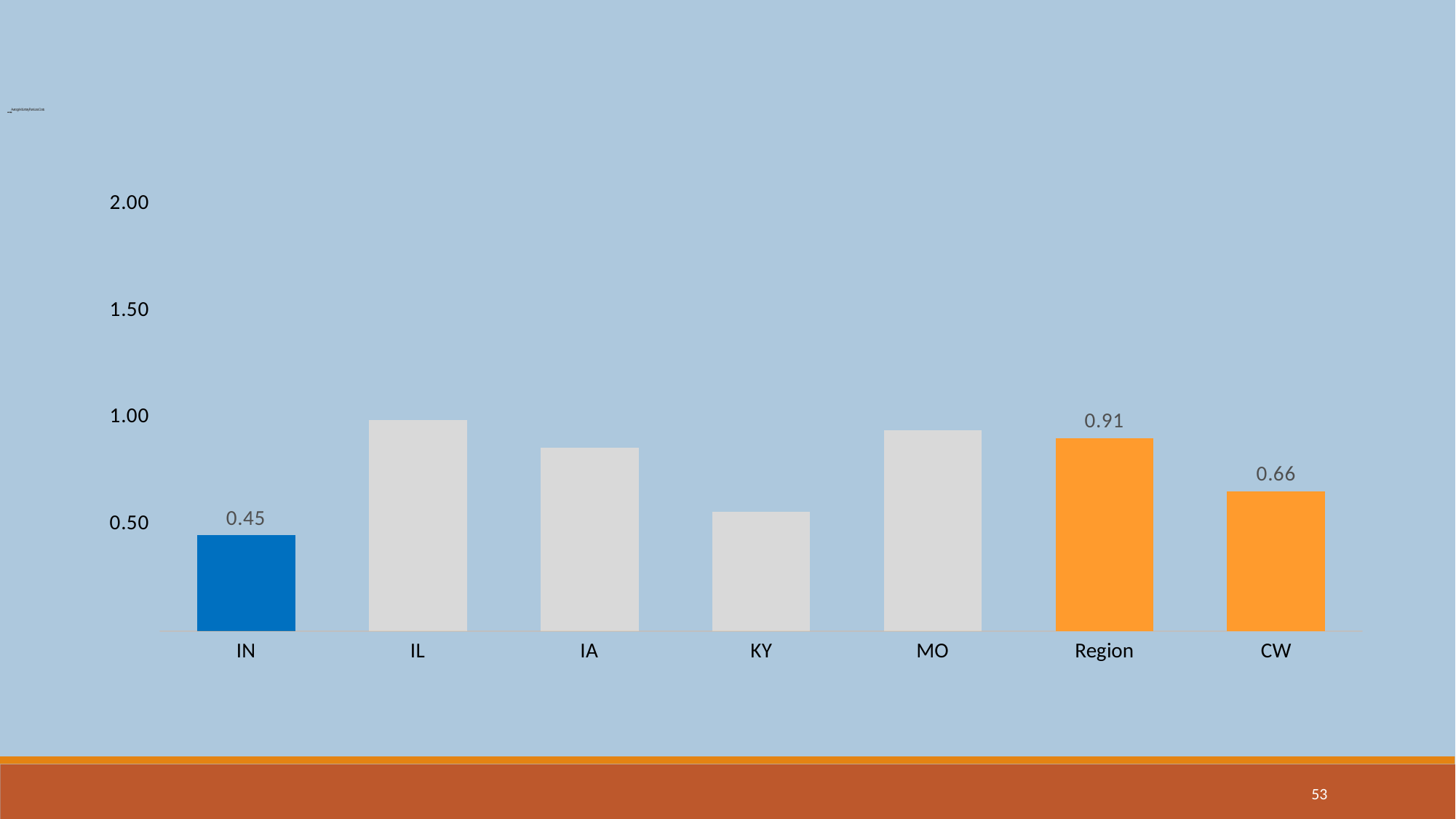
Is the value for MO greater or less than 1.00? less What kind of chart is shown on the slide? bar chart Is the value for IA greater or less than 0.50? greater Which category has the lowest value? IN What is the difference between the values for Region and CW? 0.25 What is the difference between the values for Region and IN? 0.46 What colour is the bar for IN? blue How many categories are shown on the x axis? 7 What is the value for CW? 0.66 Which is larger, the value for CW or the value for IN? CW What is the value for Region? 0.91 What is the value for IN? 0.45